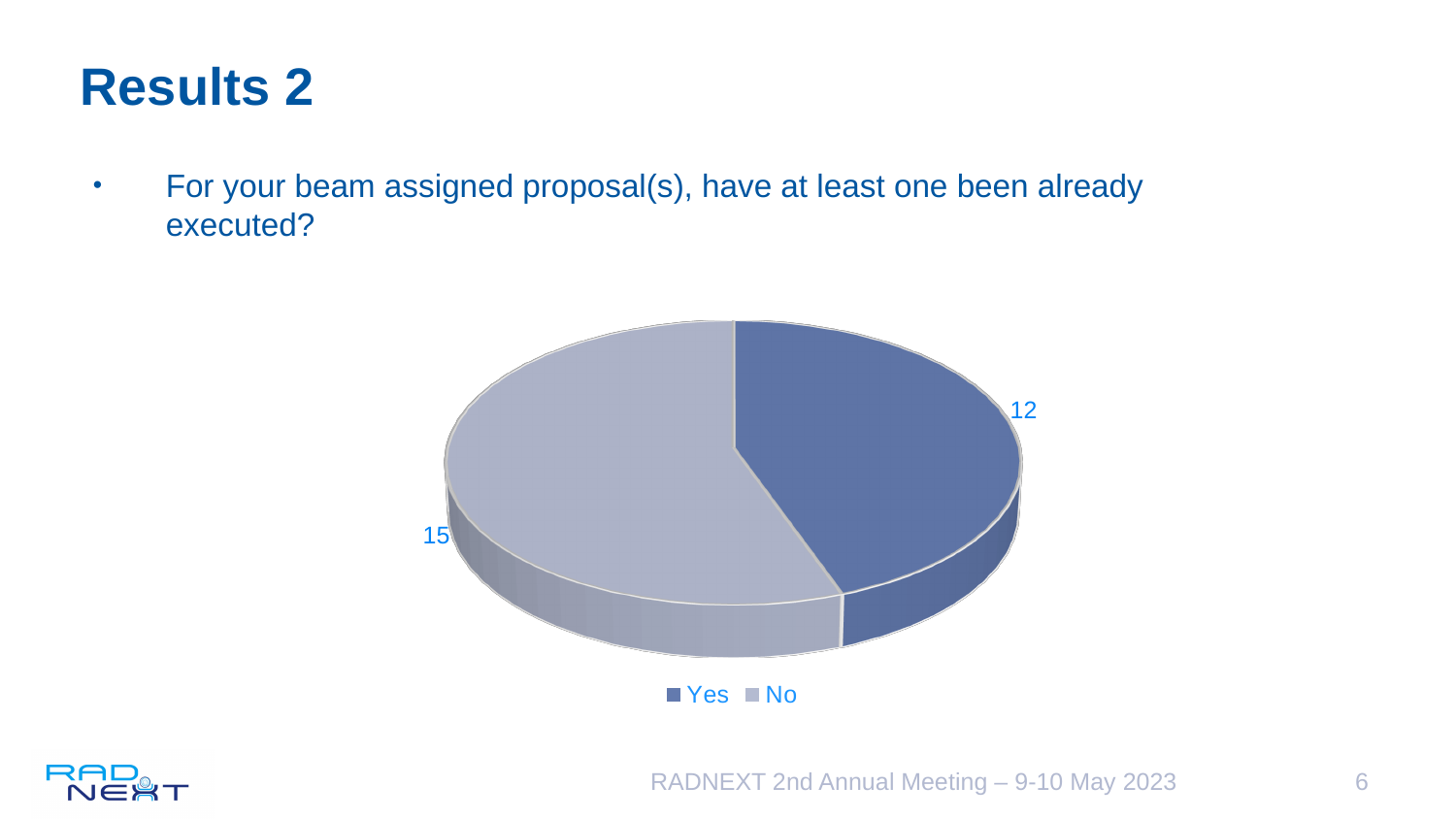
What colour is the Yes slice? dark blue What is the difference between the No and Yes values? 3 How many slices does the pie chart have? 2 Which category has the largest slice? No Where is the legend positioned relative to the pie? below the pie How many entries does the legend list? 2 Which category has the smallest slice? Yes What is the total of all slices in the pie chart? 27 Which is larger, the value for Yes or the value for No? No What is the value for Yes? 12 What is the value for No? 15 What kind of chart is shown on the slide? pie chart